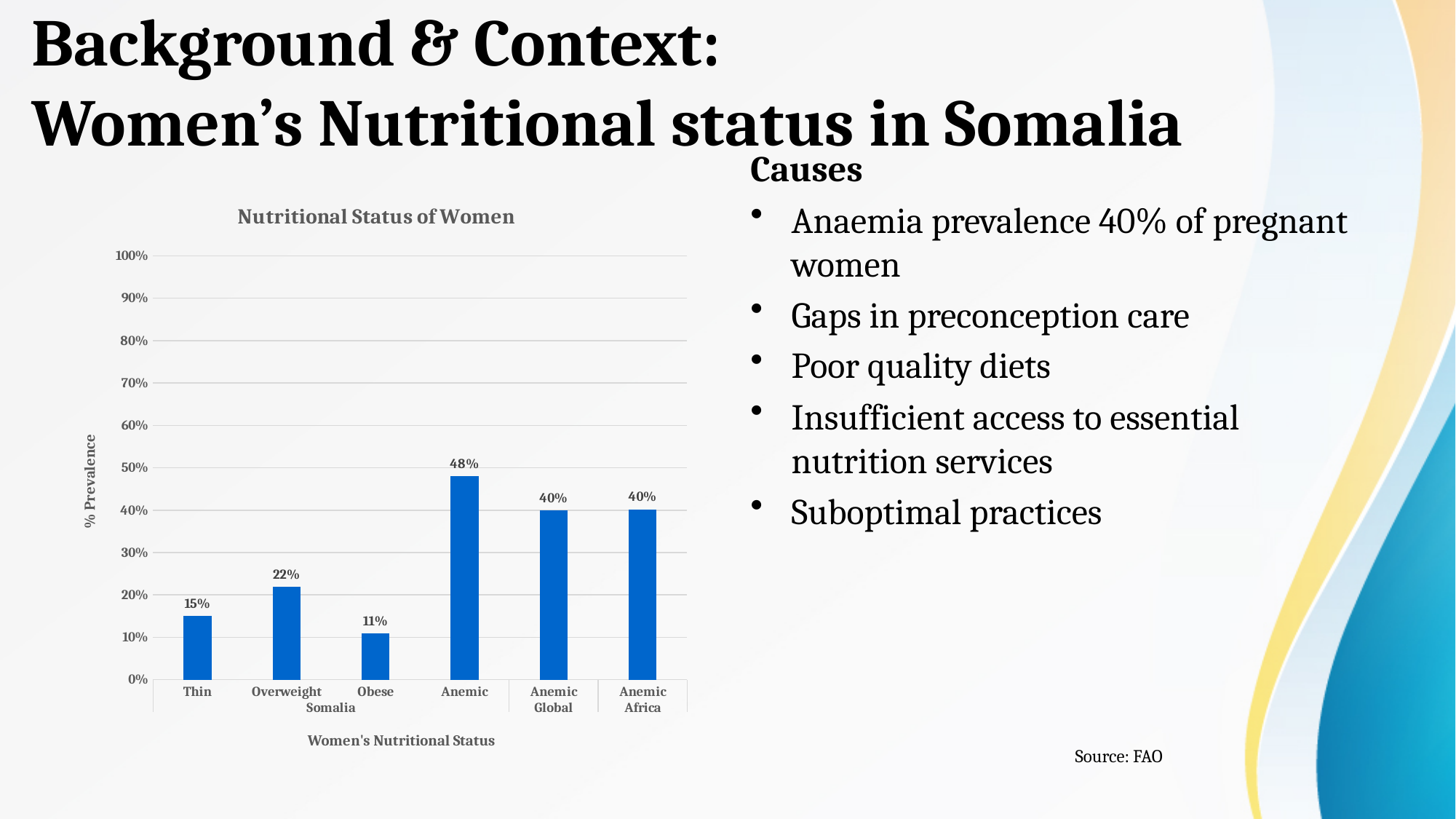
What is the value for Anemic Global in the Nutritional Status of Women chart? 40% How many categories are shown in the Nutritional Status of Women chart? 6 What is the difference between the Anemic and Anemic Africa values in the Nutritional Status of Women chart? 8% What is the value for Anemic in the Nutritional Status of Women chart? 48% Which category has the highest value in the Nutritional Status of Women chart? Anemic What kind of chart is the Nutritional Status of Women chart? Bar chart Which category has the lowest value in the Nutritional Status of Women chart? Obese What is the value for Thin in the Nutritional Status of Women chart? 15% What is the y-axis label of the Nutritional Status of Women chart? % Prevalence Which is larger in the Nutritional Status of Women chart, Overweight or Thin? Overweight What is the value for Overweight in the Nutritional Status of Women chart? 22% What is the value for Obese in the Nutritional Status of Women chart? 11%